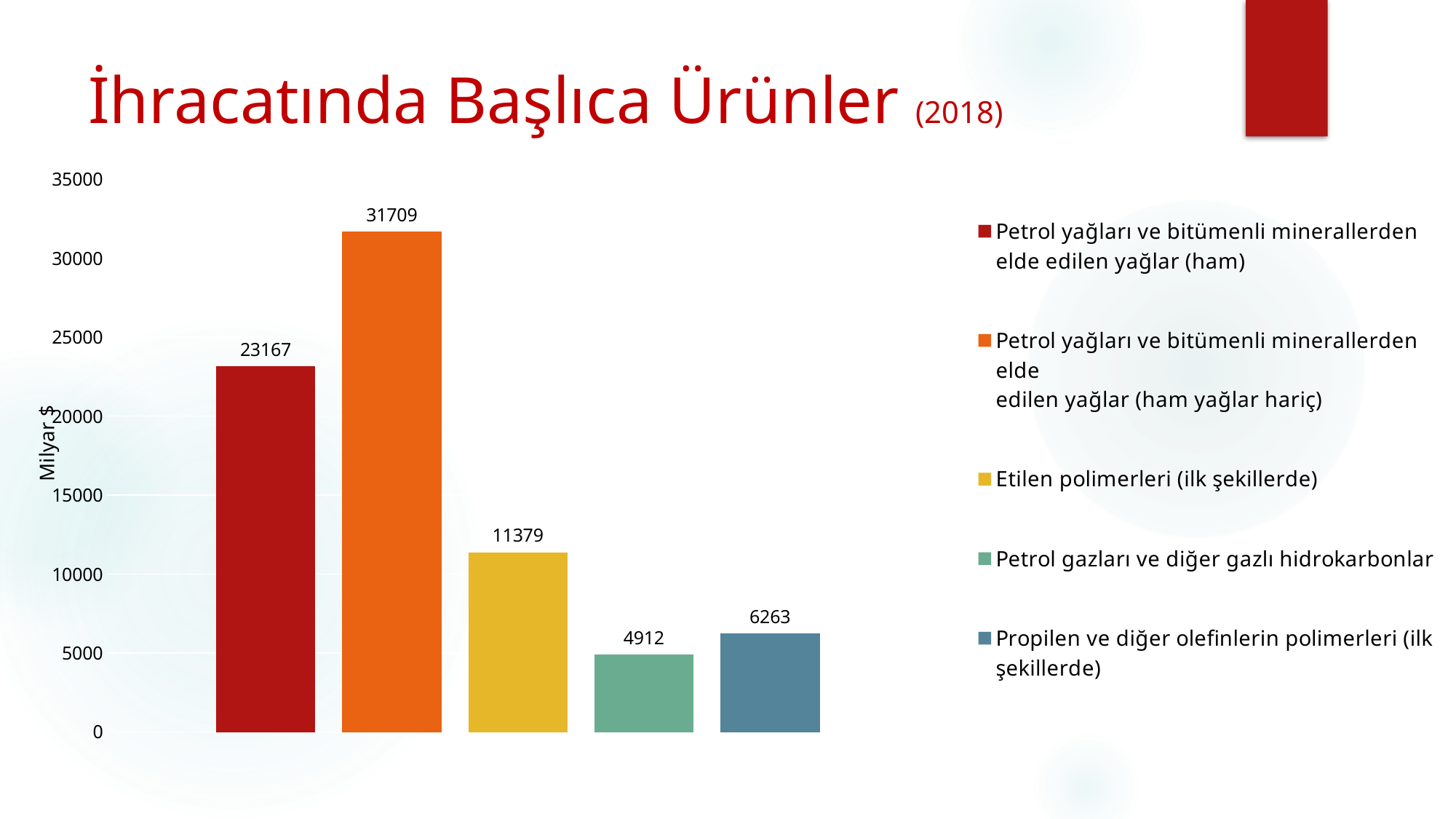
What is the value for Etilen polimerleri (ilk şekillerde)? 11379 Which category has the highest value? Petrol yağları ve bitümenli minerallerden elde edilen yağlar (ham yağlar hariç) What is the value for Propilen ve diğer olefinlerin polimerleri (ilk şekillerde)? 6263 What is the label of the vertical axis? Milyar $ Which category has the lowest value? Petrol gazları ve diğer gazlı hidrokarbonlar What is the value for Petrol gazları ve diğer gazlı hidrokarbonlar? 4912 What kind of chart is shown on the slide? bar chart What is the value for Petrol yağları ve bitümenli minerallerden elde edilen yağlar (ham)? 23167 How many bars are shown in the chart? 5 Is the value for Etilen polimerleri (ilk şekillerde) greater or less than 10000? greater Which is larger: the value for Propilen ve diğer olefinlerin polimerleri (ilk şekillerde) or the value for Petrol gazları ve diğer gazlı hidrokarbonlar? Propilen ve diğer olefinlerin polimerleri (ilk şekillerde) What is the difference between the values for Petrol yağları ve bitümenli minerallerden elde edilen yağlar (ham yağlar hariç) and Petrol yağları ve bitümenli minerallerden elde edilen yağlar (ham)? 8542